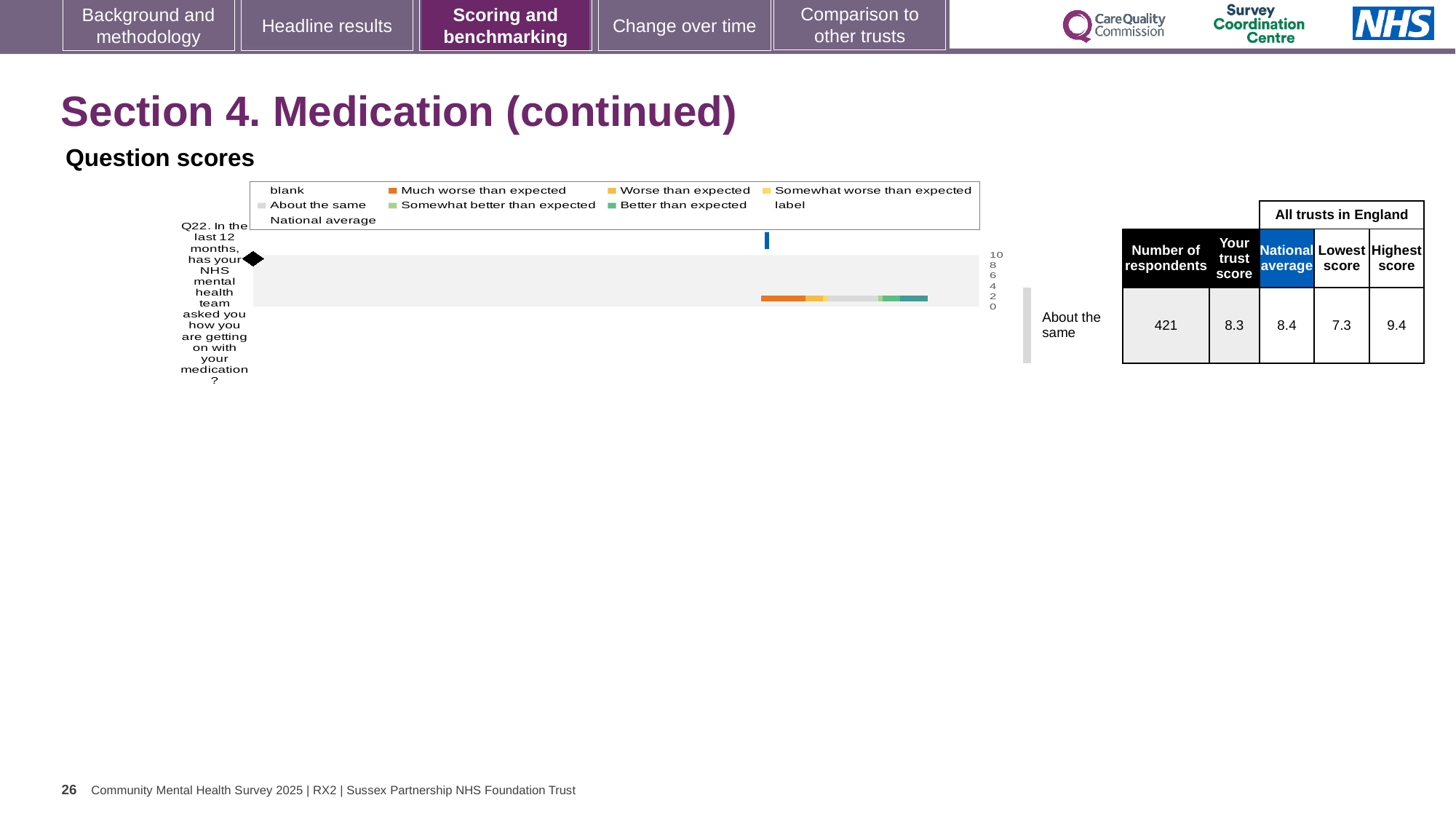
Which benchmark category is the trust's Q22 score placed in? About the same Is the trust's score for Q22 greater or less than 8? greater What is the difference between the highest and lowest trust scores in England for Q22? 2.1 What colour represents 'Much worse than expected' in the chart legend? orange What is the trust's score for Q22 on the question scores chart? 8.3 How many questions are plotted on the question scores chart? 1 What is the lowest score among all trusts in England for Q22? 7.3 What is the national average score for Q22? 8.4 What kind of chart is used to show the question scores for Q22? bar chart What is the highest score among all trusts in England for Q22? 9.4 How many respondents answered Q22? 421 Which is larger for Q22, the trust's score or the national average? national average